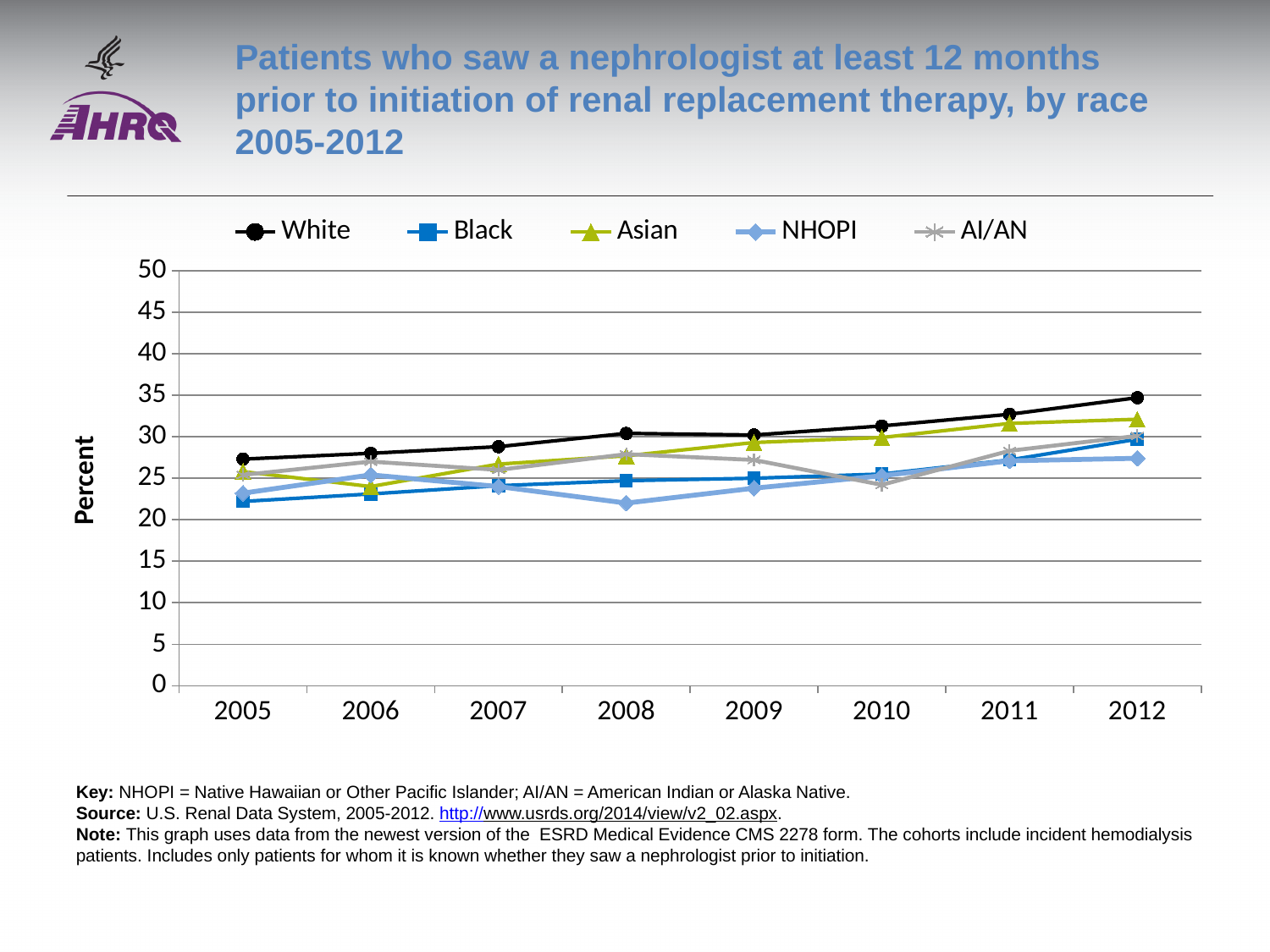
Is the value for NHOPI in 2008 greater or less than 25? less Does the White series rise or fall from 2005 to 2012? Rise What kind of chart is shown on the slide? Line chart What is the label on the y axis? Percent Which race group has the highest value in 2012? White How many series does the legend list? 5 Is the value for White in 2012 greater or less than 30? greater Which race group has the lowest value in 2008? NHOPI Which race group has the lowest value in 2005? Black How many years are shown along the x axis? 8 Which is larger in 2009, the value for Asian or the value for NHOPI? Asian Is the value for Black in 2005 greater or less than 25? less